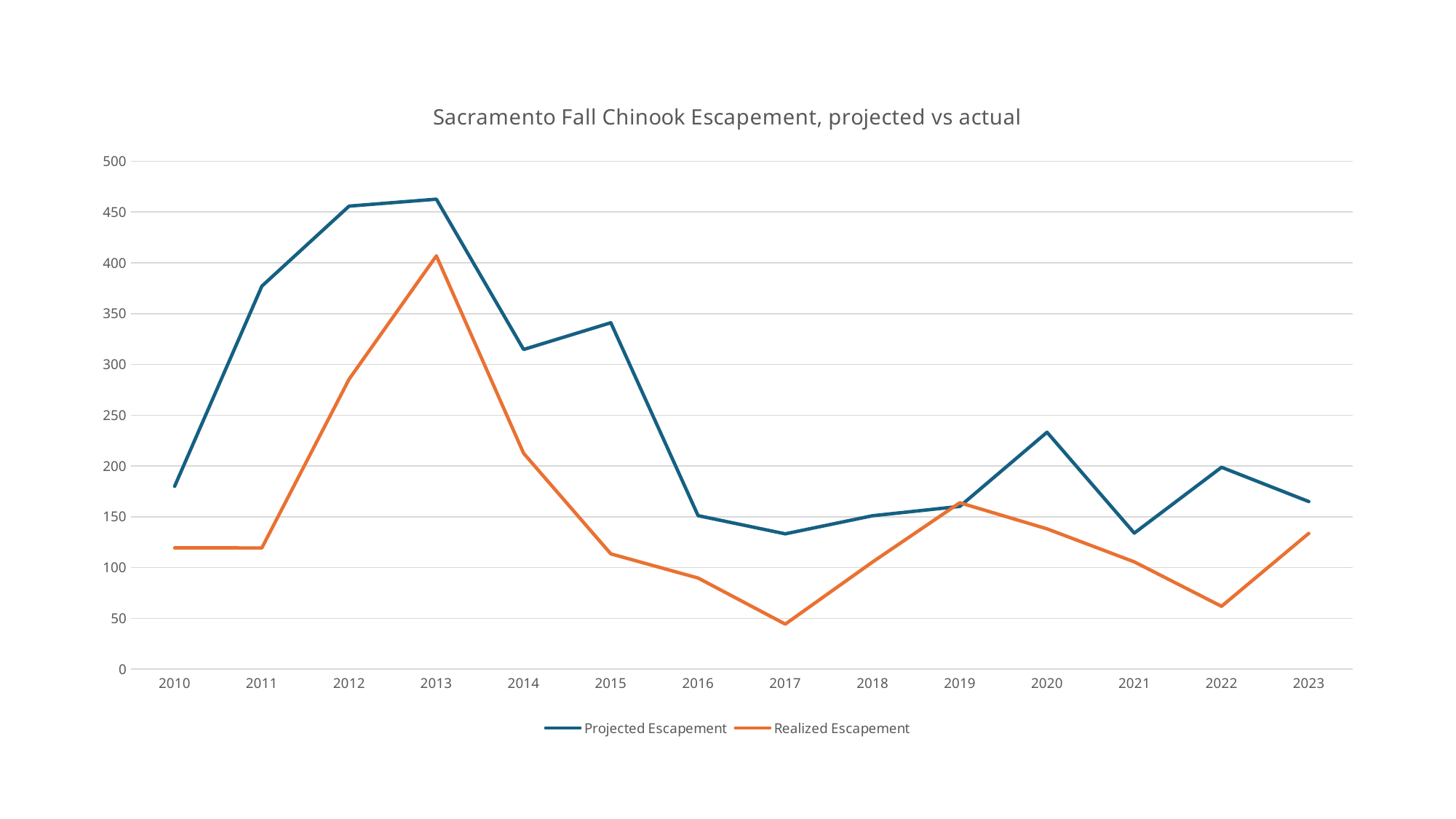
In 2014, which is larger: Projected Escapement or Realized Escapement? Projected Escapement Which series is drawn in orange? Realized Escapement In which year is Realized Escapement lowest? 2017 Is the Realized Escapement value for 2013 greater or less than 400? greater How many series does the legend list? 2 In which year is Realized Escapement highest? 2013 Is the Realized Escapement value for 2017 greater or less than 50? less How many years are plotted along the x axis? 14 What is the title of the chart? Sacramento Fall Chinook Escapement, projected vs actual What kind of chart is shown on the slide? line chart Does Realized Escapement rise or fall from 2013 to 2017? fall Is the Projected Escapement value for 2012 greater or less than 450? greater